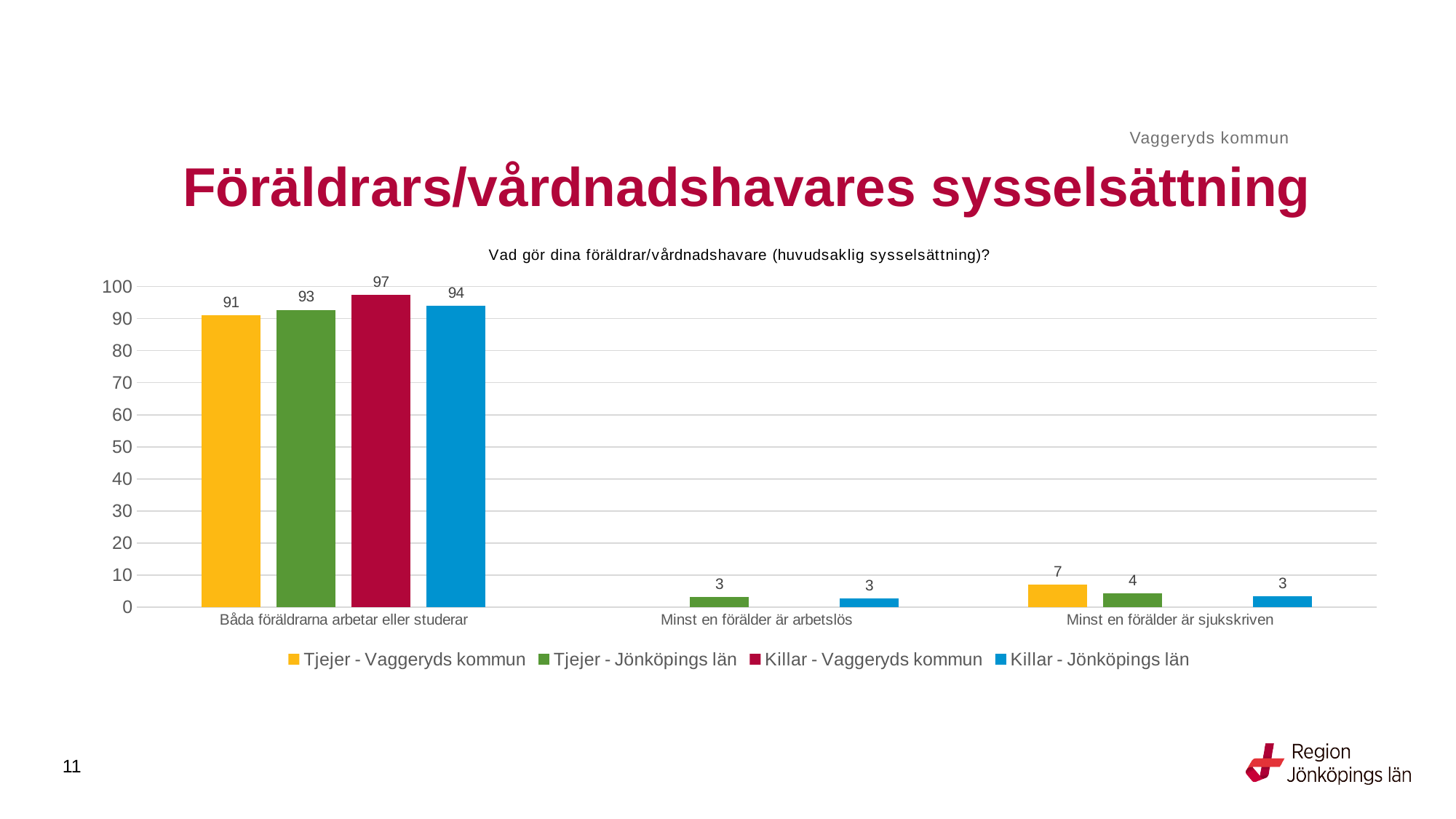
How many categories are shown on the x axis? 3 Is the value for Killar - Jönköpings län in 'Båda föräldrarna arbetar eller studerar' greater or less than 90? greater Which series has the highest value in the category 'Båda föräldrarna arbetar eller studerar'? Killar - Vaggeryds kommun How many series does the legend list? 4 What is the value for Tjejer - Jönköpings län in the category 'Minst en förälder är arbetslös'? 3 What is the difference between Killar - Vaggeryds kommun and Tjejer - Vaggeryds kommun in the category 'Båda föräldrarna arbetar eller studerar'? 6 What is the value for Killar - Vaggeryds kommun in the category 'Båda föräldrarna arbetar eller studerar'? 97 What is the value for Tjejer - Vaggeryds kommun in the category 'Minst en förälder är sjukskriven'? 7 In the category 'Minst en förälder är sjukskriven', which is larger: Tjejer - Vaggeryds kommun or Tjejer - Jönköpings län? Tjejer - Vaggeryds kommun What kind of chart is shown on the slide? Bar chart Which series has the lowest value in the category 'Båda föräldrarna arbetar eller studerar'? Tjejer - Vaggeryds kommun What is the question shown as the chart's title? Vad gör dina föräldrar/vårdnadshavare (huvudsaklig sysselsättning)?